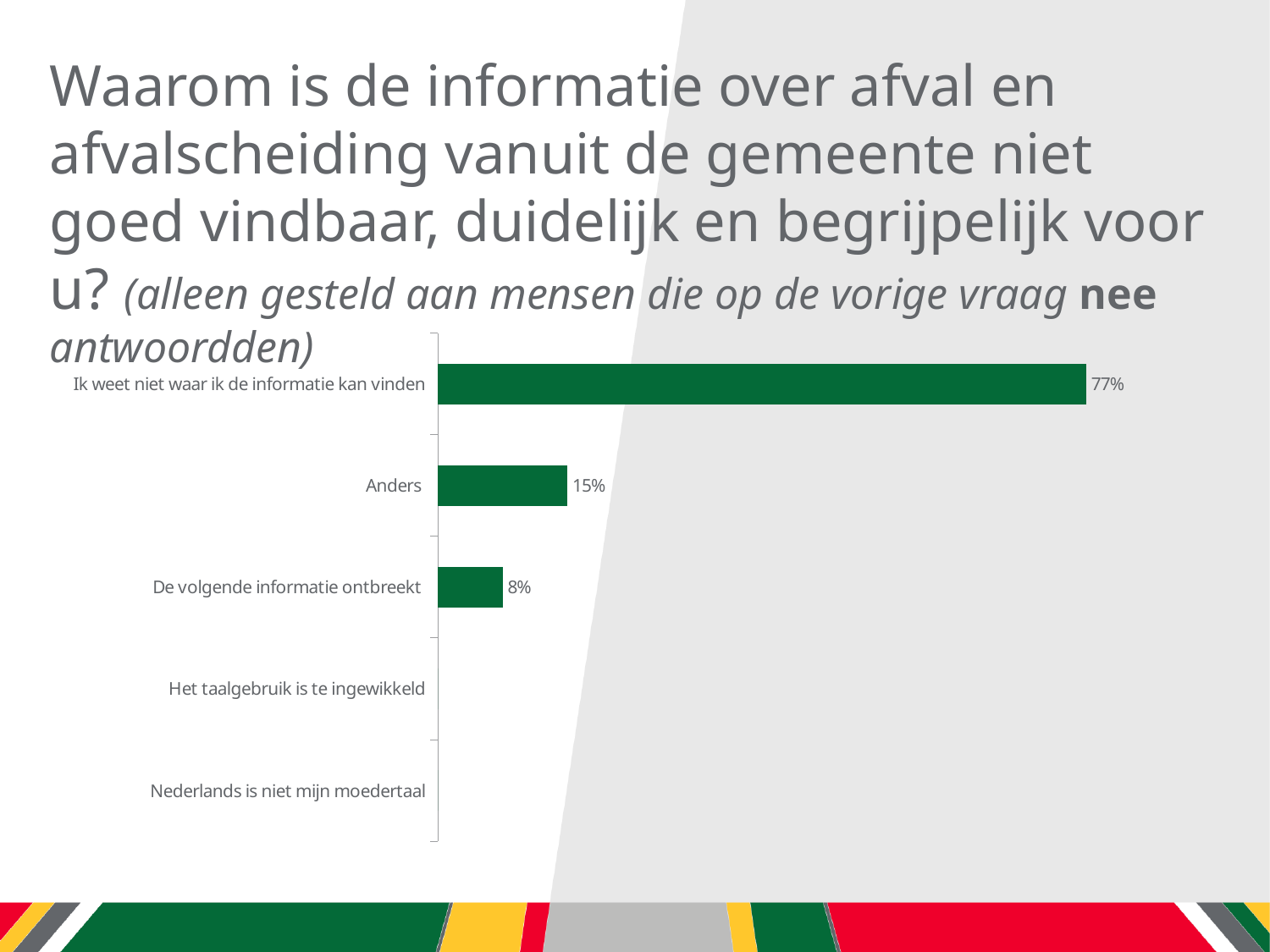
What is the value for "Anders"? 15% What is the value for "Ik weet niet waar ik de informatie kan vinden"? 77% How many categories have no visible bar on the chart? 2 How many categories are shown on the chart? 5 What is the difference between the values for "Ik weet niet waar ik de informatie kan vinden" and "Anders"? 62% What kind of chart is shown on the slide? Bar chart Which category is listed at the bottom of the chart? Nederlands is niet mijn moedertaal Which category has the highest value? Ik weet niet waar ik de informatie kan vinden What is the value for "De volgende informatie ontbreekt"? 8% What is the difference between the values for "Anders" and "De volgende informatie ontbreekt"? 7% Which is larger, the value for "Anders" or the value for "De volgende informatie ontbreekt"? Anders What colour are the bars on the chart? Green